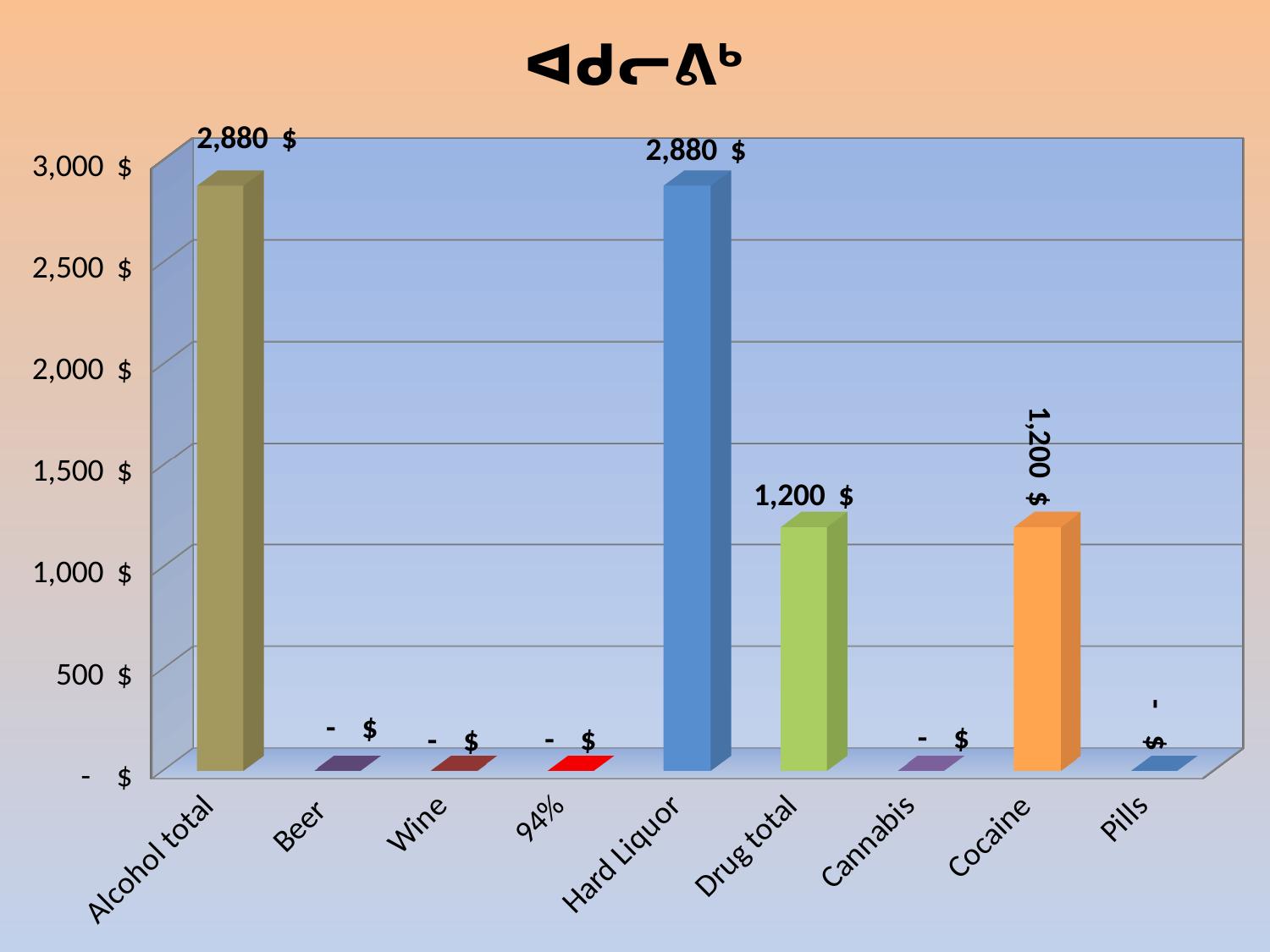
What is the value for Hard Liquor? 2,880 $ What is the difference between the values for Alcohol total and Drug total? 1,680 $ What is the difference between the values for Hard Liquor and Cocaine? 1,680 $ What kind of chart is shown on the slide? bar chart What is the value for Alcohol total? 2,880 $ How many categories are shown on the x axis? 9 Which is larger, the value for Hard Liquor or the value for Cocaine? Hard Liquor What is the value shown for Beer? - $ Is the value for Drug total greater or less than 1,000 $? greater What is the value for Drug total? 1,200 $ What colour is the bar for Cocaine? orange What is the value for Cocaine? 1,200 $